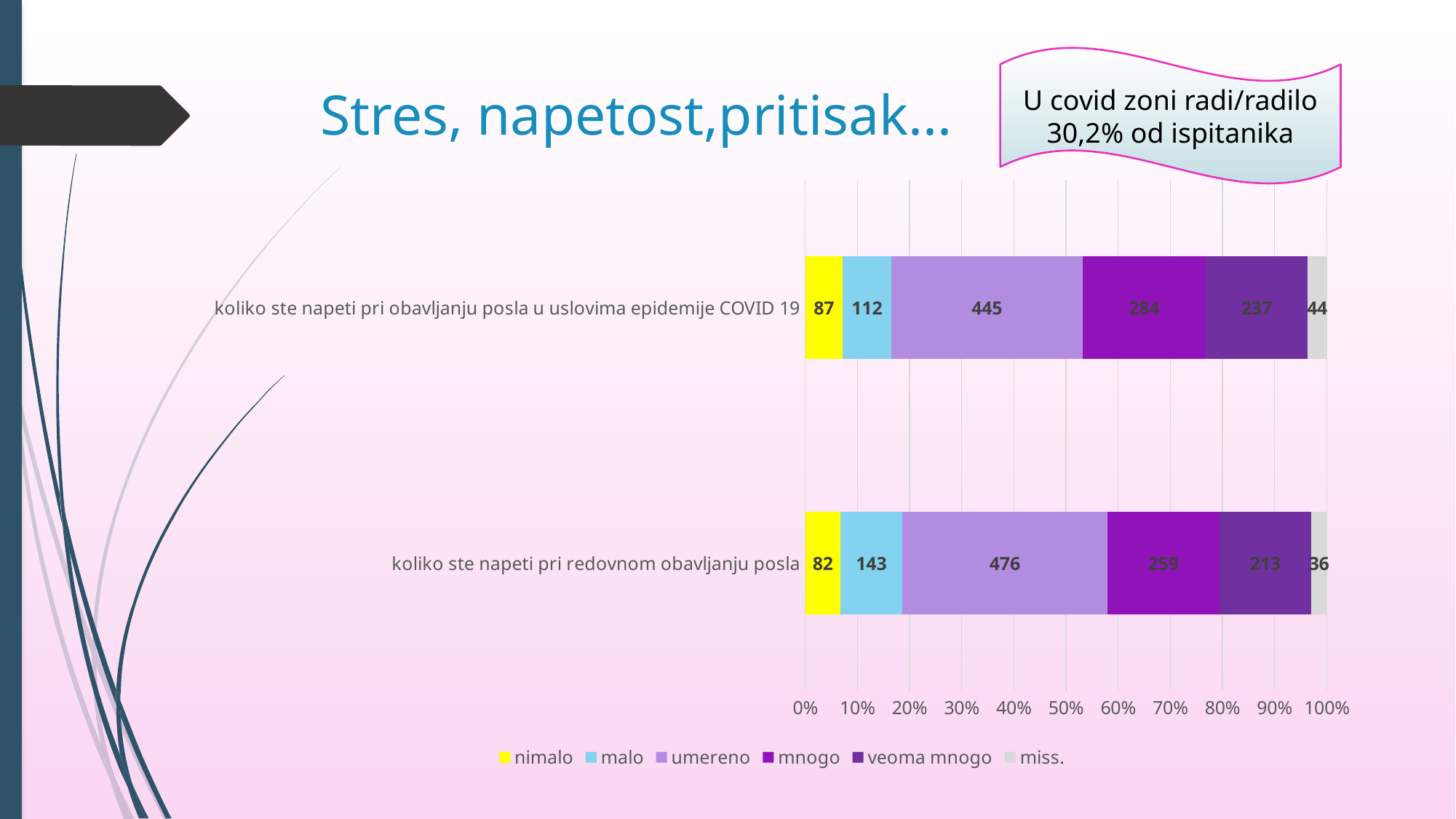
What colour represents the 'nimalo' series in the chart? yellow What is the value of 'umereno' for 'koliko ste napeti pri obavljanju posla u uslovima epidemije COVID 19'? 445 What is the value of 'miss.' for 'koliko ste napeti pri obavljanju posla u uslovima epidemije COVID 19'? 44 Which series has the lowest value in the bar for 'koliko ste napeti pri obavljanju posla u uslovima epidemije COVID 19'? miss. What is the difference between the 'mnogo' values for the COVID 19 bar and the 'redovnom obavljanju posla' bar? 25 Which series has the highest value in the bar for 'koliko ste napeti pri redovnom obavljanju posla'? umereno How many series does the legend list? 6 What is the value of 'malo' for 'koliko ste napeti pri redovnom obavljanju posla'? 143 What kind of chart is shown on the slide? stacked bar chart How many categories (bars) are plotted in the chart? 2 What is the total of all segments in the bar for 'koliko ste napeti pri redovnom obavljanju posla'? 1209 Which bar has the larger 'veoma mnogo' value: 'koliko ste napeti pri obavljanju posla u uslovima epidemije COVID 19' or 'koliko ste napeti pri redovnom obavljanju posla'? koliko ste napeti pri obavljanju posla u uslovima epidemije COVID 19